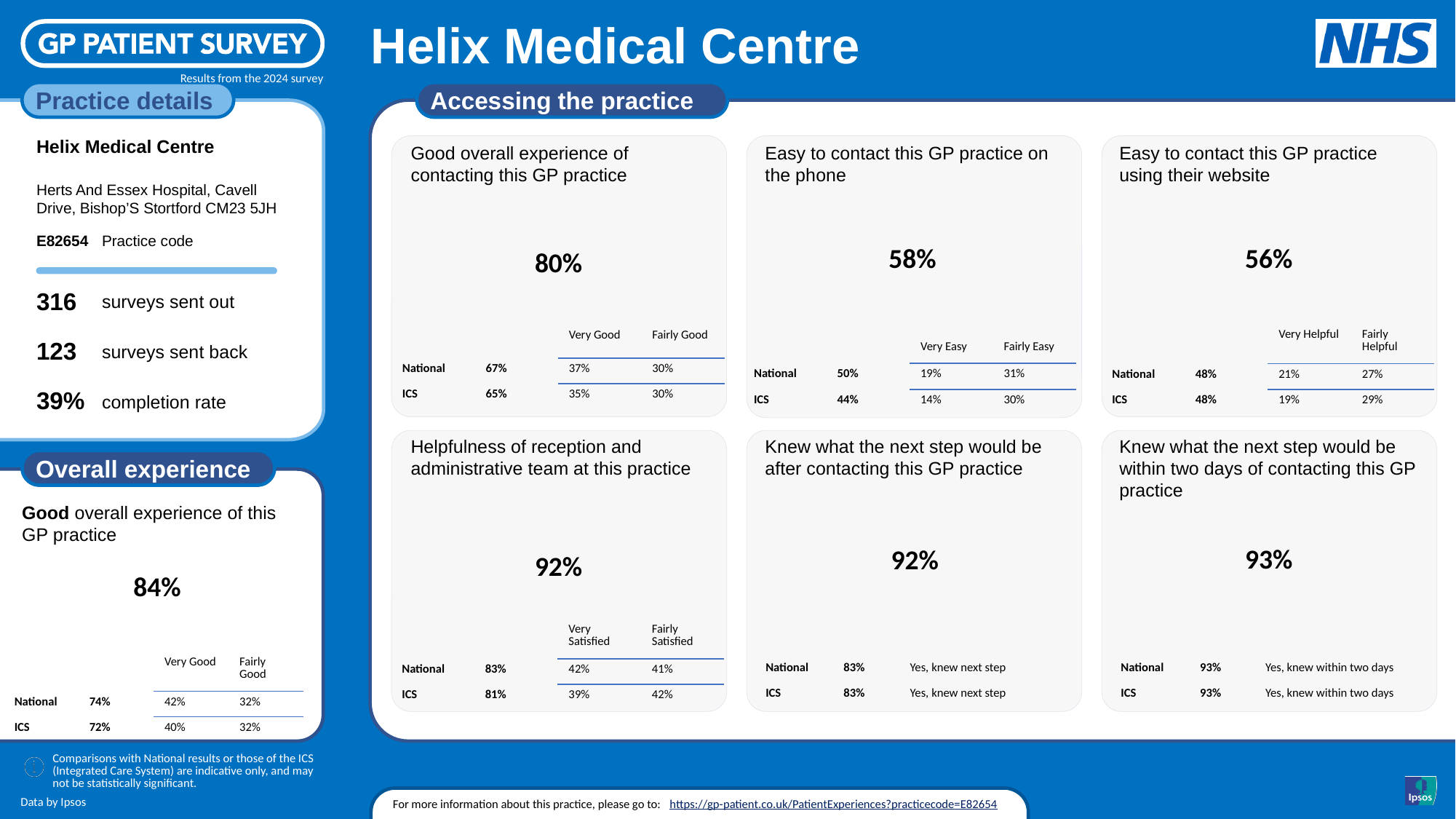
In the 'Easy to contact this GP practice on the phone' panel, what is the National value? 50% In the 'Helpfulness of reception and administrative team at this practice' panel, what is the National 'Fairly Satisfied' value? 41% In the 'Knew what the next step would be within two days of contacting this GP practice' panel, what is the practice's headline percentage? 93% How many panels are shown in the 'Accessing the practice' section? 6 In the 'Overall experience' section, what is the difference between the National 'Very Good' value and the ICS 'Very Good' value? 2 percentage points Among the six 'Accessing the practice' panels, which has the highest headline percentage? Knew what the next step would be within two days of contacting this GP practice (93%) In the 'Easy to contact this GP practice on the phone' panel, which is larger: the practice's headline value or the ICS value? The practice's headline value (58%) In the 'Overall experience' section, what is the ICS value for good overall experience of this GP practice? 72% In the 'Easy to contact this GP practice using their website' panel, what is the ICS 'Very Helpful' value? 19% Among the six 'Accessing the practice' panels, which has the lowest headline percentage? Easy to contact this GP practice using their website (56%) In the 'Good overall experience of contacting this GP practice' panel, what is the practice's headline percentage? 80% In the 'Good overall experience of contacting this GP practice' panel, what is the difference between the practice's 80% and the National 67%? 13 percentage points